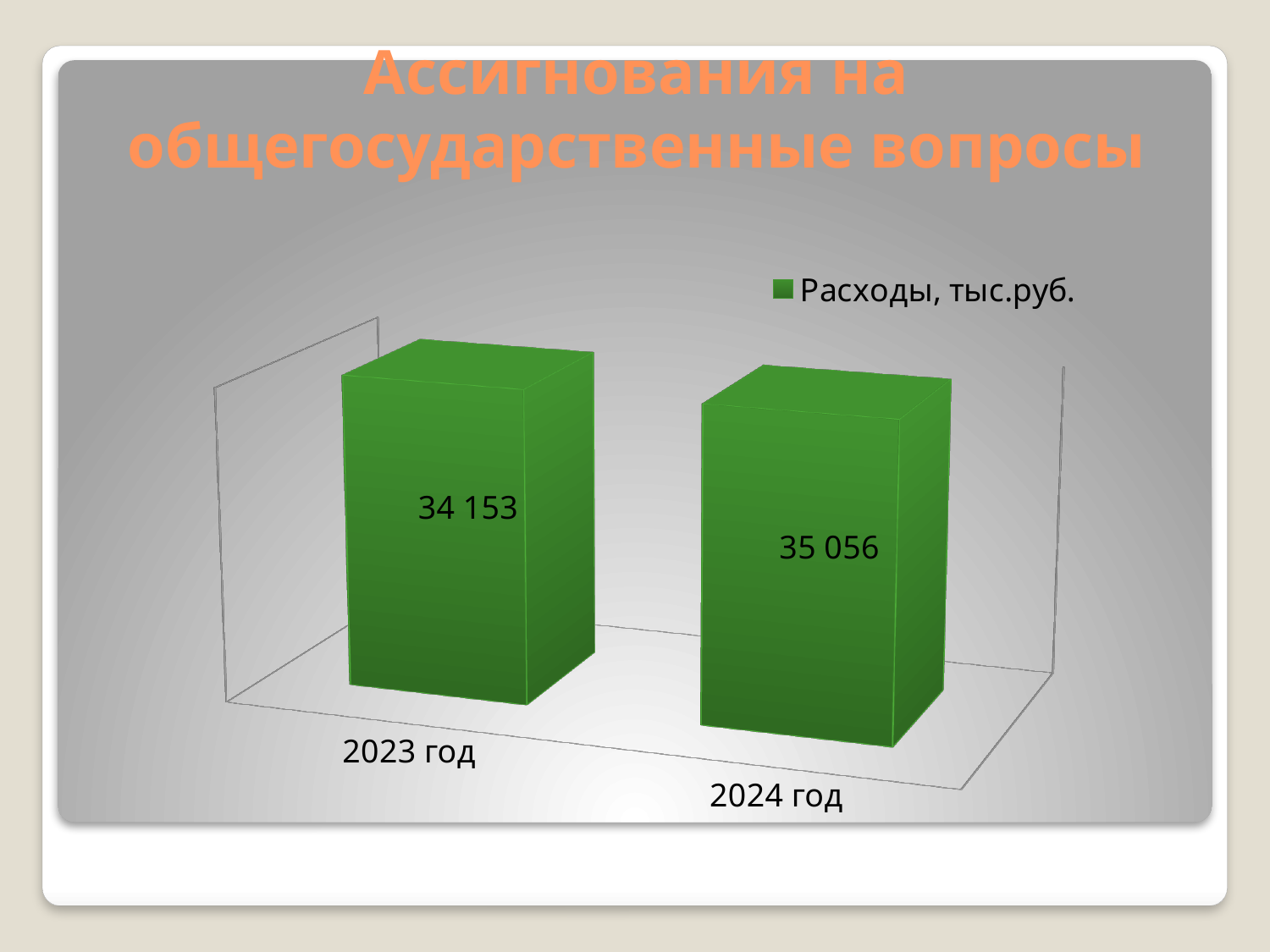
Which year has the highest value? 2024 год What is the difference between the values for 2024 год and 2023 год? 903 What series name is shown in the legend? Расходы, тыс.руб. How many series does the legend list? 1 How many categories are shown on the chart? 2 What is the title of the chart? Ассигнования на общегосударственные вопросы What is the value for 2024 год? 35 056 What kind of chart is shown on the slide? Bar chart Which is larger, the value for 2023 год or the value for 2024 год? 2024 год Which year has the lowest value? 2023 год Do the values rise or fall from 2023 год to 2024 год? Rise What is the value for 2023 год? 34 153